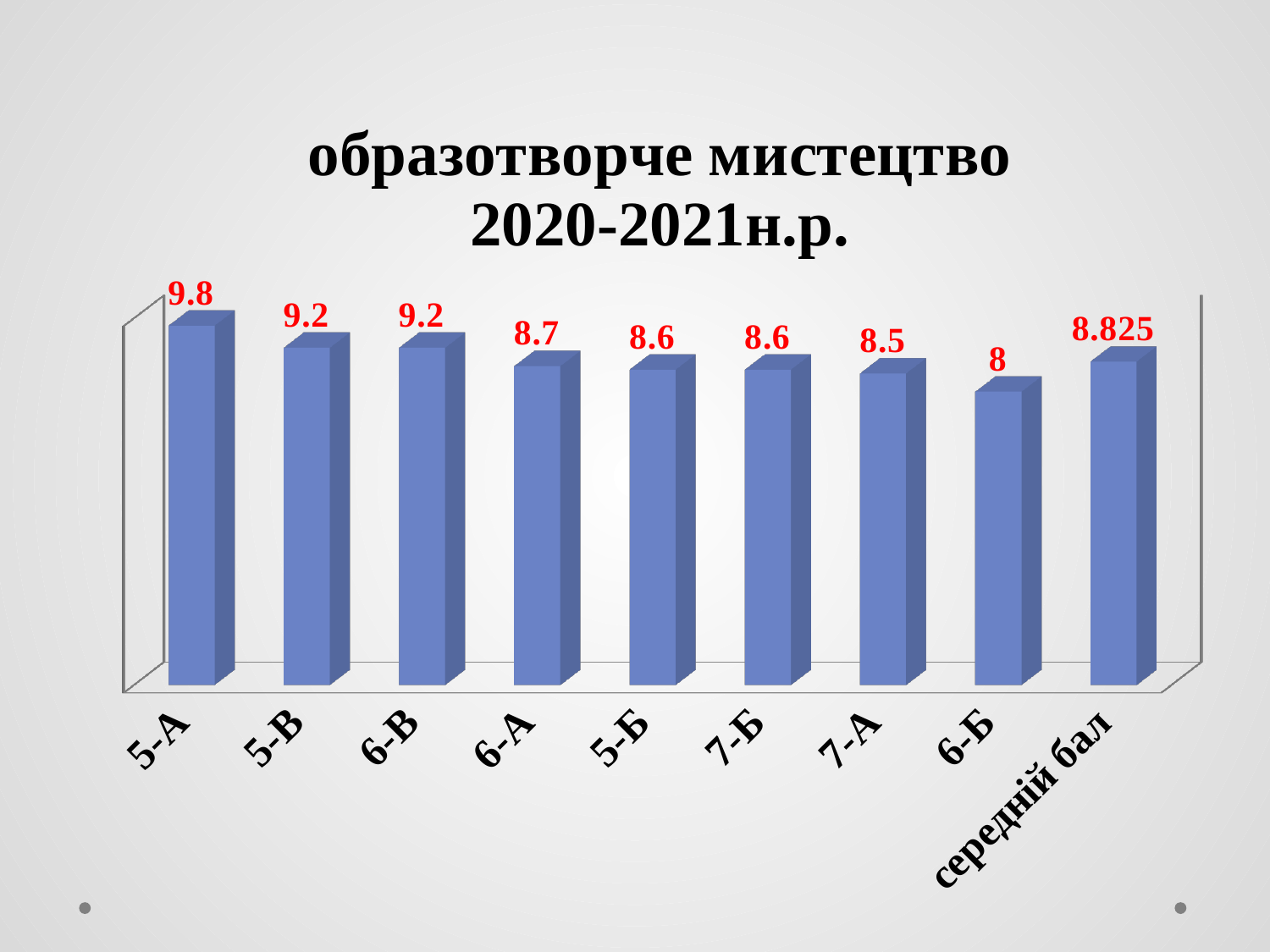
What is the value for 6-Б? 8 What is the value for 7-А? 8.5 What kind of chart is shown on the slide? Bar chart What is the value shown for середній бал? 8.825 Which category has the highest value? 5-А What is the title of the chart? образотворче мистецтво 2020-2021н.р. Which is larger, the value for 5-В or the value for 6-А? 5-В What is the value for 5-А? 9.8 What is the difference between the values for 5-А and 6-Б? 1.8 Which category has the lowest value? 6-Б How many categories are shown on the x axis? 9 What is the difference between the values for 6-А and 7-А? 0.2